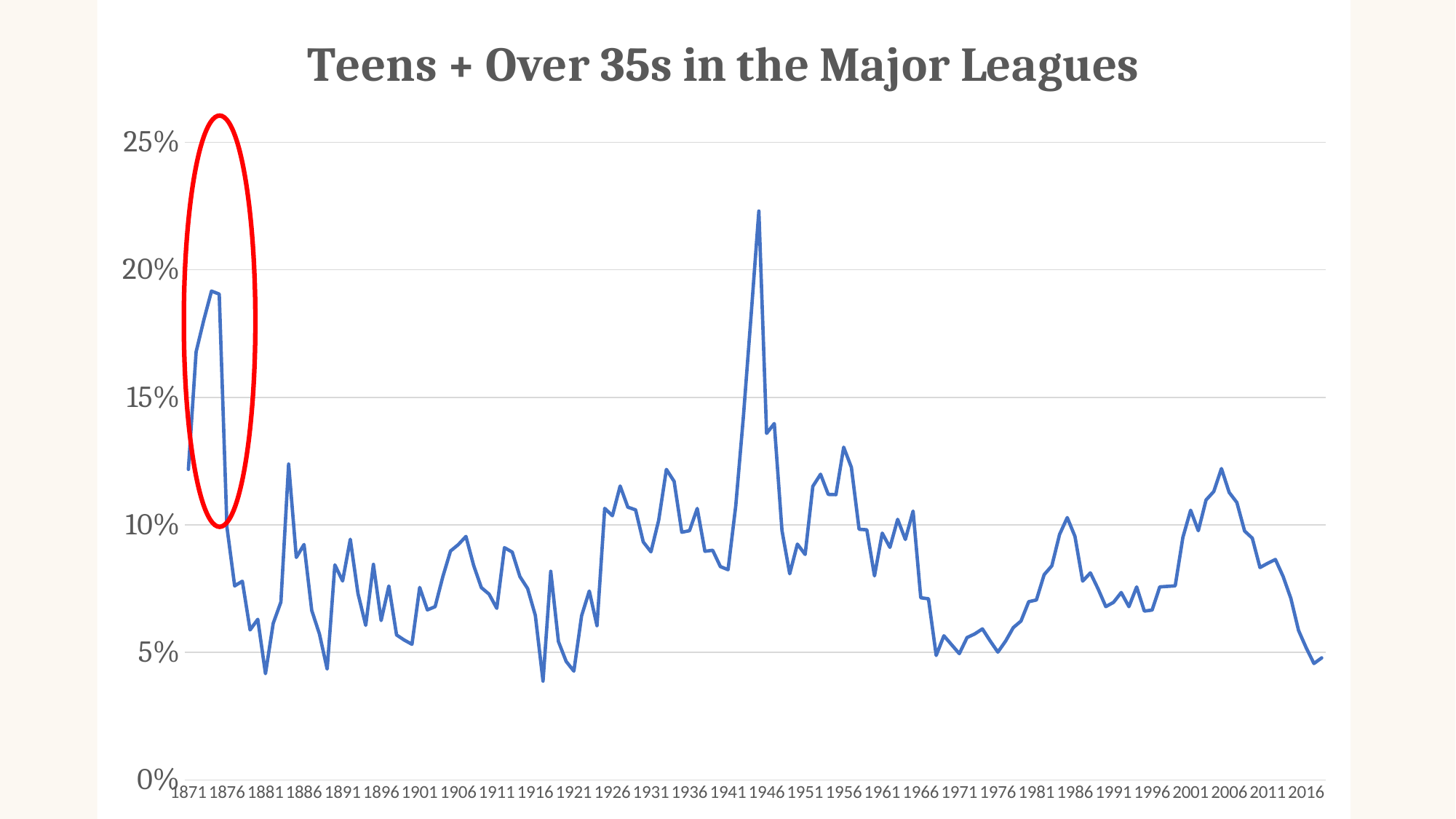
Is the value for 2006 greater or less than 10%? greater Is the value for 1881 greater or less than 5%? less Is the value for 1871 greater or less than 10%? greater What kind of chart is shown on the slide? line chart What is the title of the chart? Teens + Over 35s in the Major Leagues Which is larger, the value for 1871 or the value for 1881? 1871 Does the value rise or fall from 2006 to 2016? fall In which decade does the line reach its highest point? 1940s Which part of the chart is highlighted with a red circle? the early years around 1871-1876